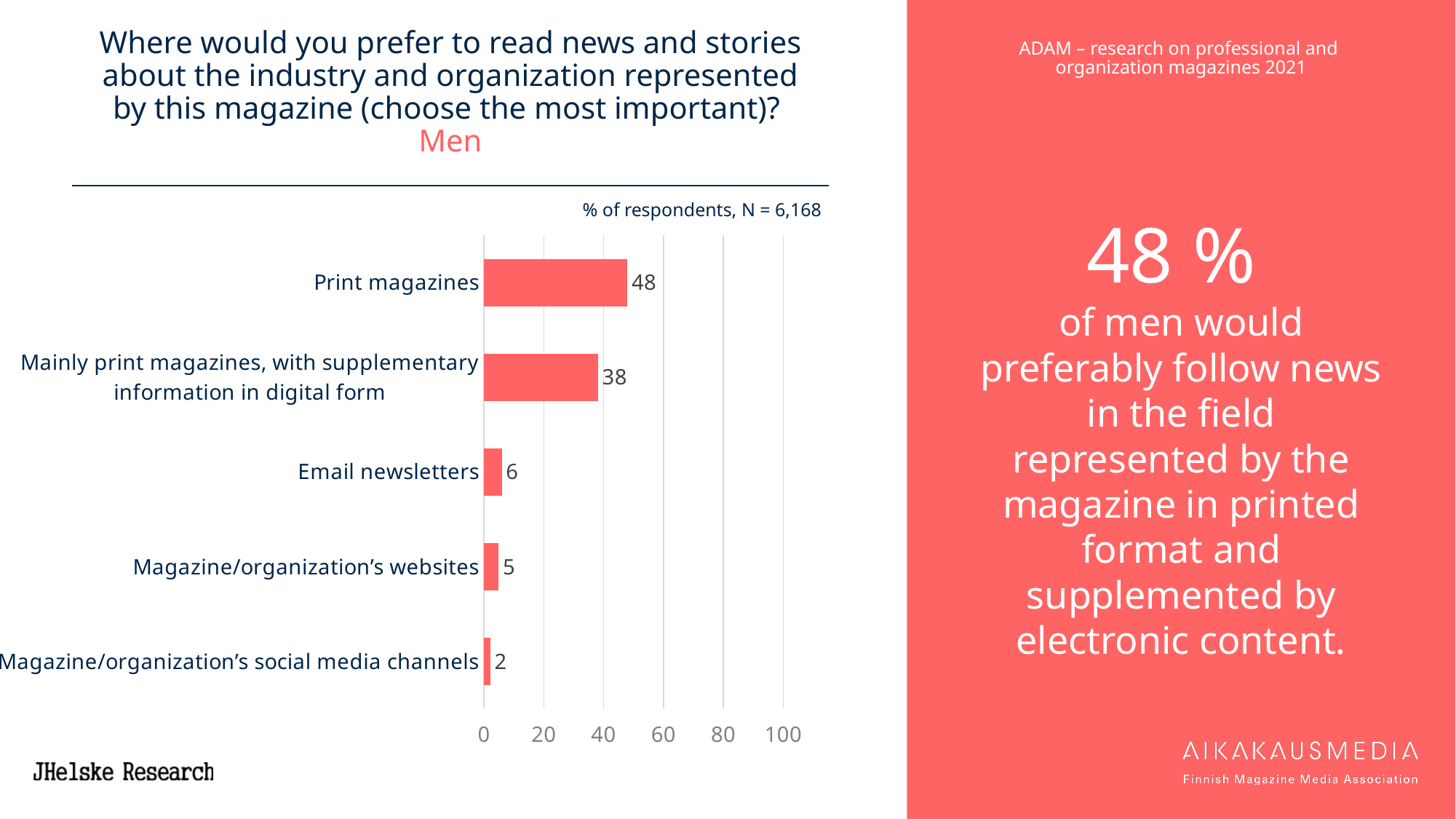
What percentage of men prefer print magazines for reading news and stories about the industry? 48 What kind of chart is shown on the slide? Bar chart What is the number of respondents (N) stated above the chart? 6,168 What is the difference between the values for print magazines and mainly print magazines with supplementary digital information? 10 What is the value for magazine/organization's social media channels? 2 Which category has the lowest value? Magazine/organization's social media channels Which category has the highest value? Print magazines Is the value for print magazines greater or less than 40? greater What is the value for 'Mainly print magazines, with supplementary information in digital form'? 38 What is the value for email newsletters? 6 How many categories are shown in the chart? 5 Which is larger: the value for email newsletters or the value for magazine/organization's websites? Email newsletters